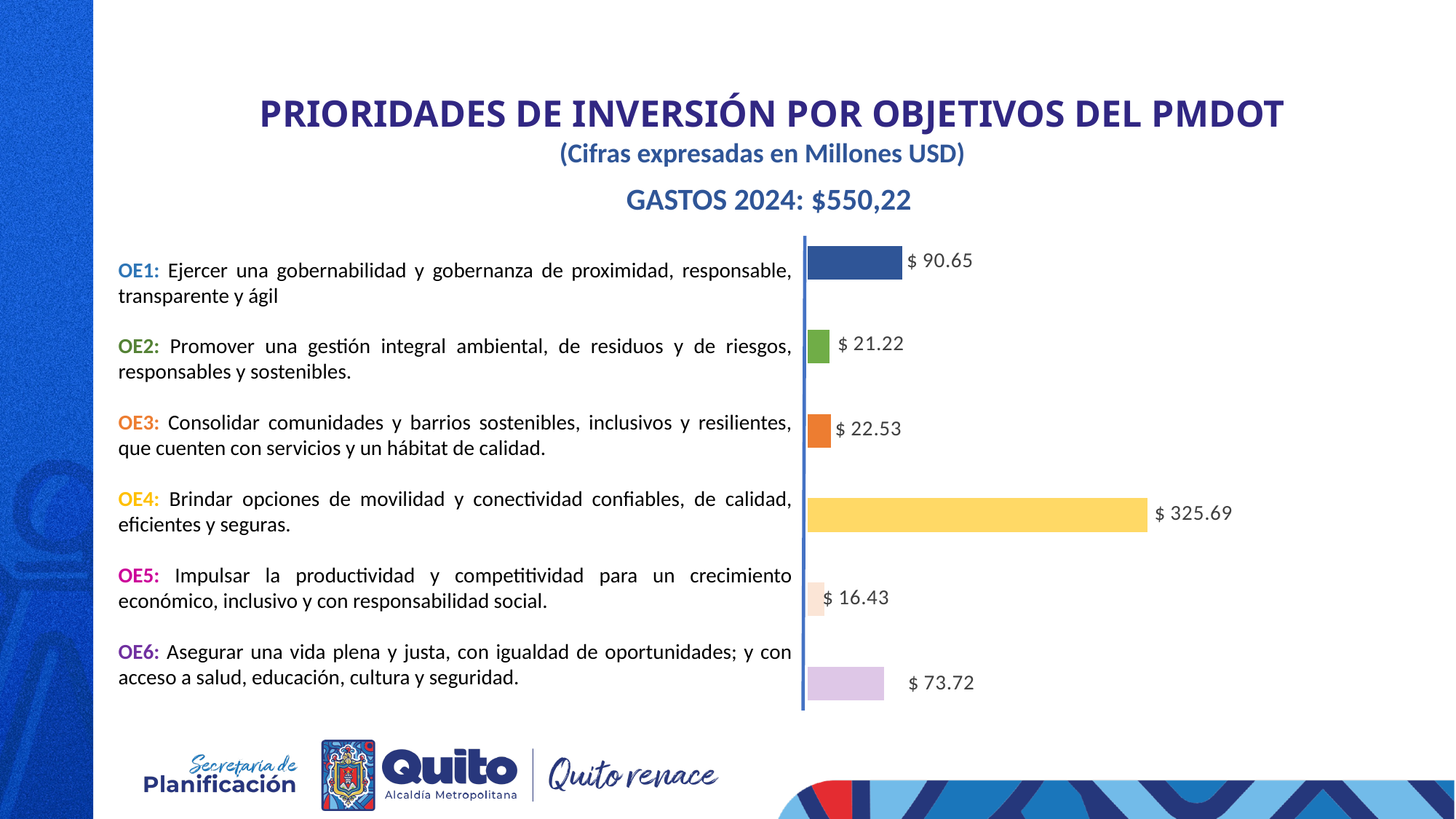
What total for GASTOS 2024 is stated above the chart? $550,22 What is the value for OE4 in the chart? $ 325.69 Which objective has the lowest value in the chart? OE5 What is the value for OE5 in the chart? $ 16.43 What is the value for OE1 in the chart? $ 90.65 Which is larger, the value for OE2 or the value for OE3? OE3 How many objectives (bars) are shown in the chart? 6 What is the value for OE6 in the chart? $ 73.72 What is the difference between the values for OE3 and OE2? 1.31 Which objective has the highest value in the chart? OE4 What kind of chart is shown on the slide? Bar chart What is the difference between the values for OE4 and OE1? 235.04